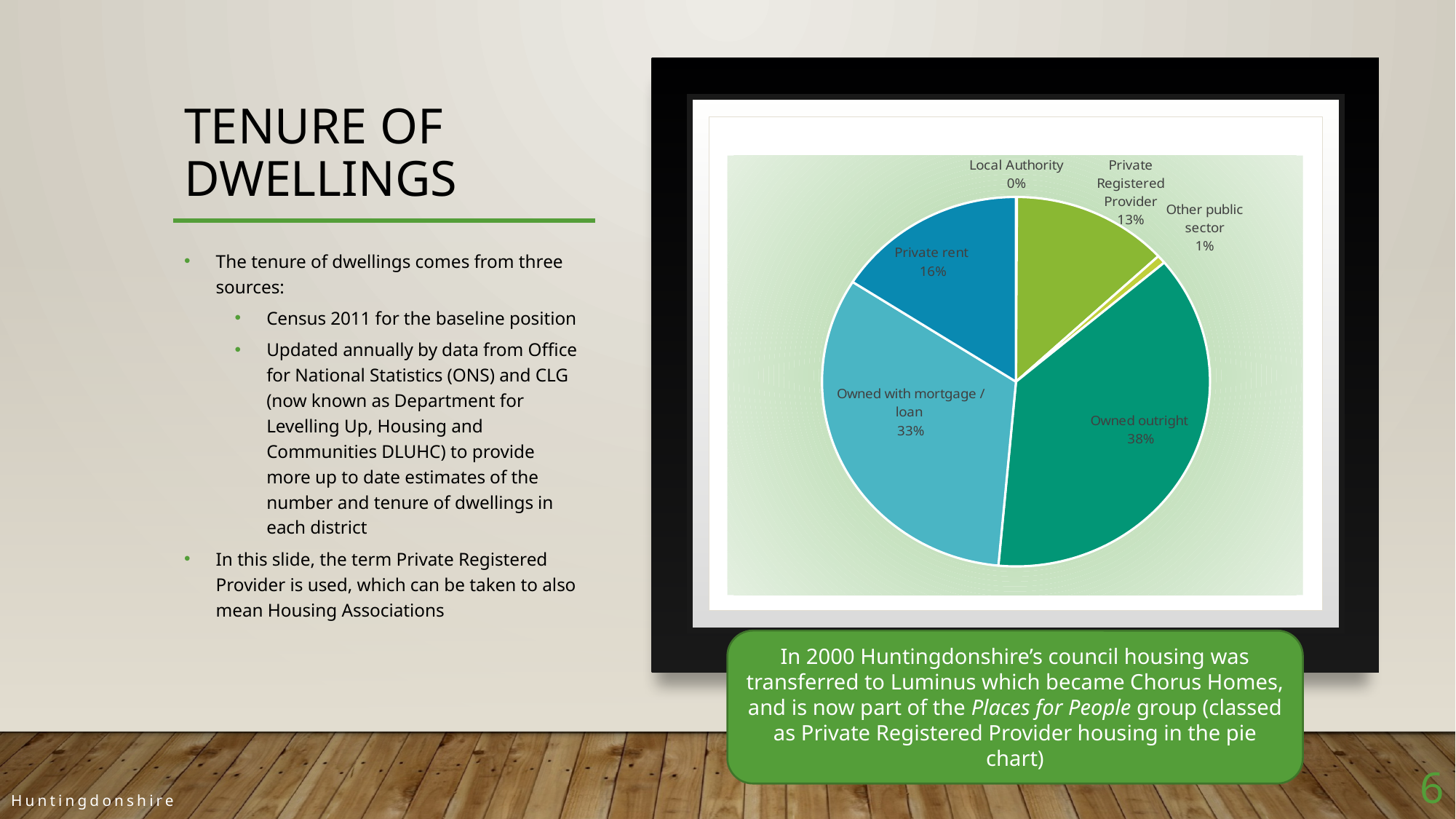
What share of dwellings is Owned outright? 38% What share of dwellings is Private rent? 16% What kind of chart is shown on the slide? pie chart What share of dwellings is Local Authority? 0% Which is larger, the share for Private rent or the share for Private Registered Provider? Private rent What share of dwellings is Private Registered Provider? 13% What share of dwellings is Owned with mortgage / loan? 33% Which tenure category has the smallest share of the pie? Local Authority Which tenure category has the largest share of the pie? Owned outright What share of dwellings is Other public sector? 1% How many tenure categories are shown in the pie chart? 6 What is the difference in percentage points between Owned outright and Owned with mortgage / loan? 5